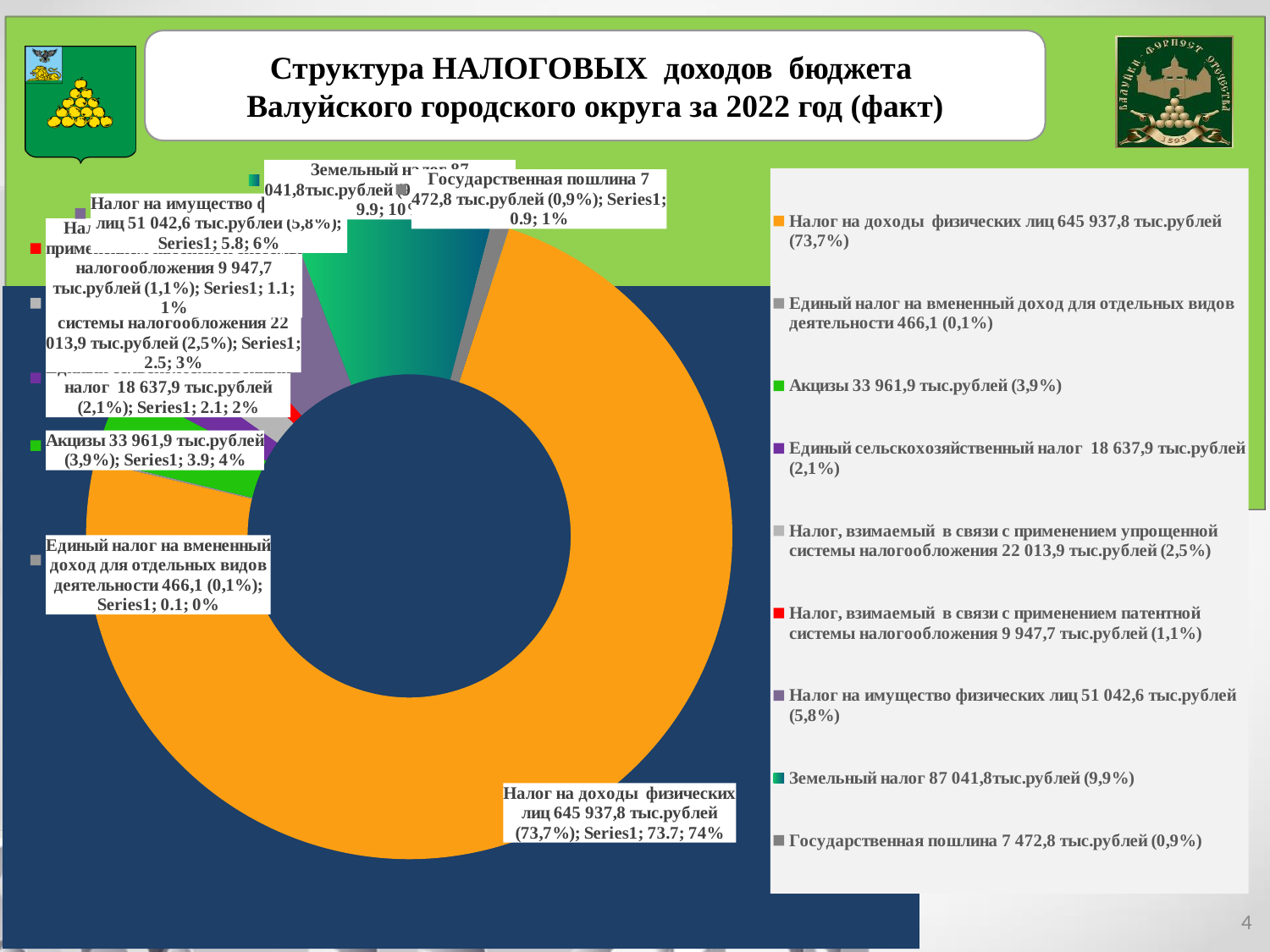
How many categories does the legend of the chart list? 9 Which is larger: Акцизы or Земельный налог? Земельный налог What kind of chart is shown on the slide? doughnut (pie) chart What is the value shown for Земельный налог? 87 041,8 тыс.рублей What is the value shown for Налог на имущество физических лиц? 51 042,6 тыс.рублей What is the value shown for Акцизы? 33 961,9 тыс.рублей Which category has the largest share of tax revenues in the chart? Налог на доходы физических лиц What share of tax revenues does Налог на доходы физических лиц account for? 73,7% Which category has the smallest share of tax revenues in the chart? Единый налог на вмененный доход для отдельных видов деятельности What is the title of the slide containing the chart? Структура НАЛОГОВЫХ доходов бюджета Валуйского городского округа за 2022 год (факт) What is the difference in percentage share between Земельный налог (9,9%) and Налог на имущество физических лиц (5,8%)? 4,1% What share of tax revenues does Государственная пошлина account for? 0,9%